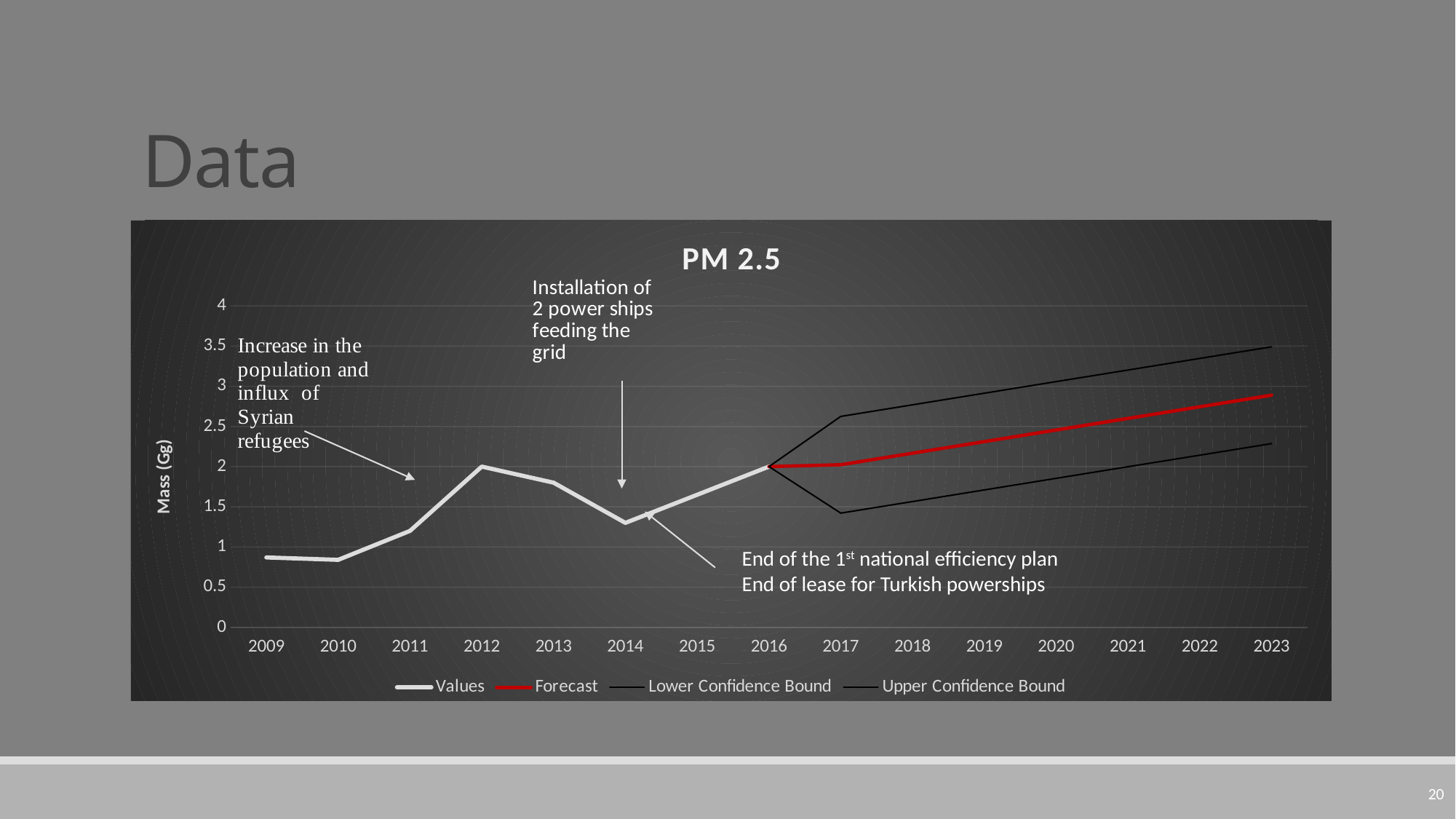
Is the Values series for 2012 greater or less than 1.5? greater How many series does the chart legend list? 4 Is the Values series for 2014 greater or less than 1.5? less What kind of chart is shown on the slide? line chart What is the label of the vertical axis? Mass (Gg) Which is larger in 2023, the Upper Confidence Bound or the Lower Confidence Bound? Upper Confidence Bound Is the Forecast value for 2023 greater or less than 2.5? greater What is the title of the chart? PM 2.5 Does the Forecast series rise or fall from 2017 to 2023? rise How many years are shown on the x axis of the chart? 15